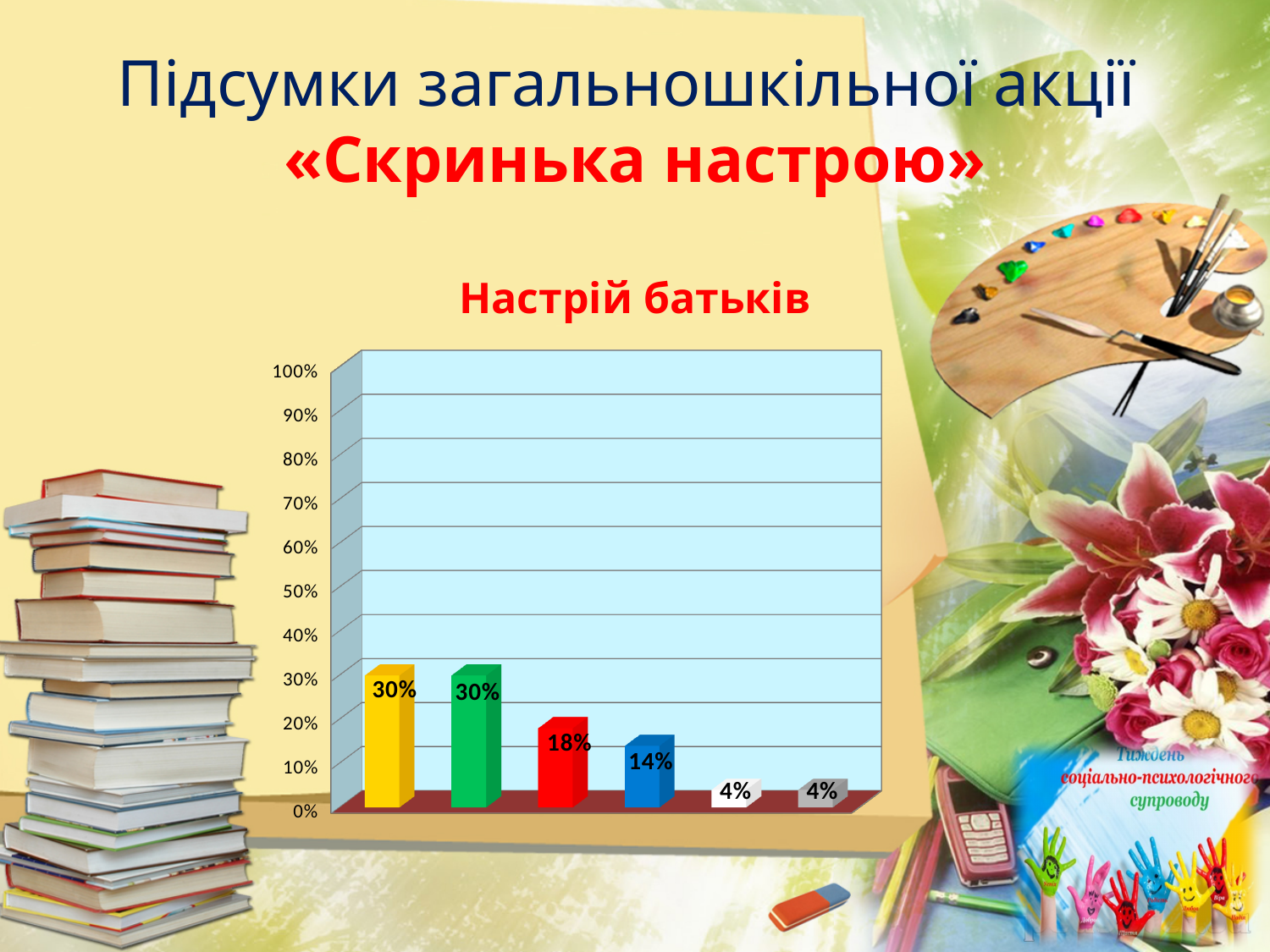
What is the difference between the red bar's value and the blue bar's value? 4% Is the value of the yellow bar greater or less than 20%? greater Which is larger, the value of the red bar or the value of the blue bar? the red bar What value is shown on the red bar (third from the left)? 18% How many bars are plotted in the chart? 6 What type of chart is shown on the slide? bar chart What value is shown on the blue bar (fourth from the left)? 14% What value is shown on the grey bar (last on the right)? 4% What is the title of the chart on the slide? Настрій батьків What value is shown on the yellow bar (first from the left)? 30% What value is shown on the green bar (second from the left)? 30% Do the bar values generally rise or fall from left to right across the chart? fall